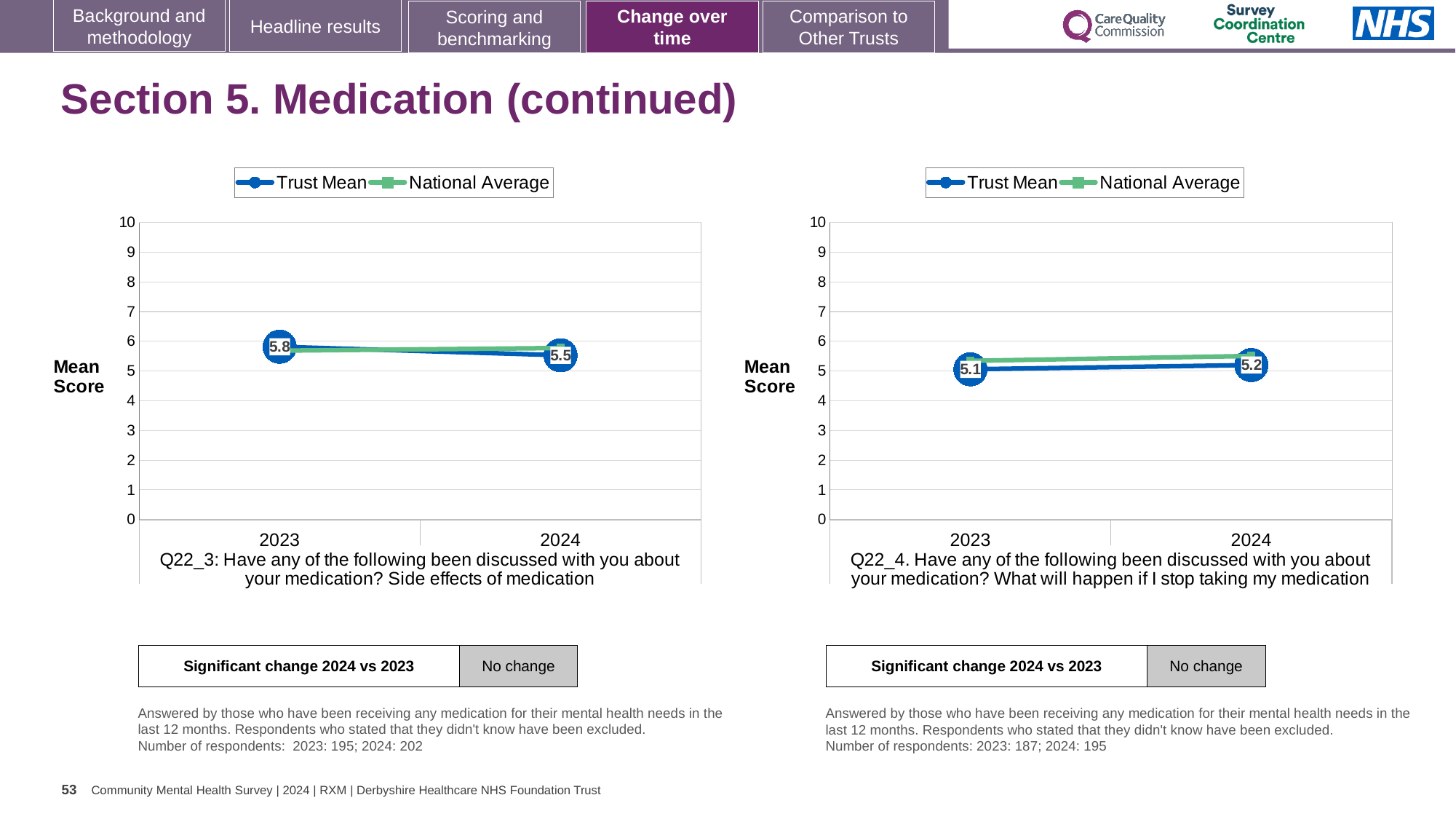
In the left chart (Q22_3), which year has the higher Trust Mean, 2023 or 2024? 2023 In the right chart (Q22_4), does the Trust Mean rise or fall from 2023 to 2024? rise In the left chart (Q22_3), what is the Trust Mean score for 2023? 5.8 What kind of chart is the right chart (Q22_4)? line chart How many series does the legend of the left chart (Q22_3) list? 2 In the left chart (Q22_3), what is the Trust Mean score for 2024? 5.5 In the right chart (Q22_4), is the National Average value for 2024 greater or less than 5? greater In the right chart (Q22_4), what is the difference between the Trust Mean for 2024 and 2023? 0.1 In the right chart (Q22_4), what is the Trust Mean score for 2024? 5.2 In the left chart (Q22_3), by how much did the Trust Mean change from 2023 to 2024? 0.3 In the right chart (Q22_4), what is the Trust Mean score for 2023? 5.1 In the left chart (Q22_3), does the Trust Mean rise or fall from 2023 to 2024? fall